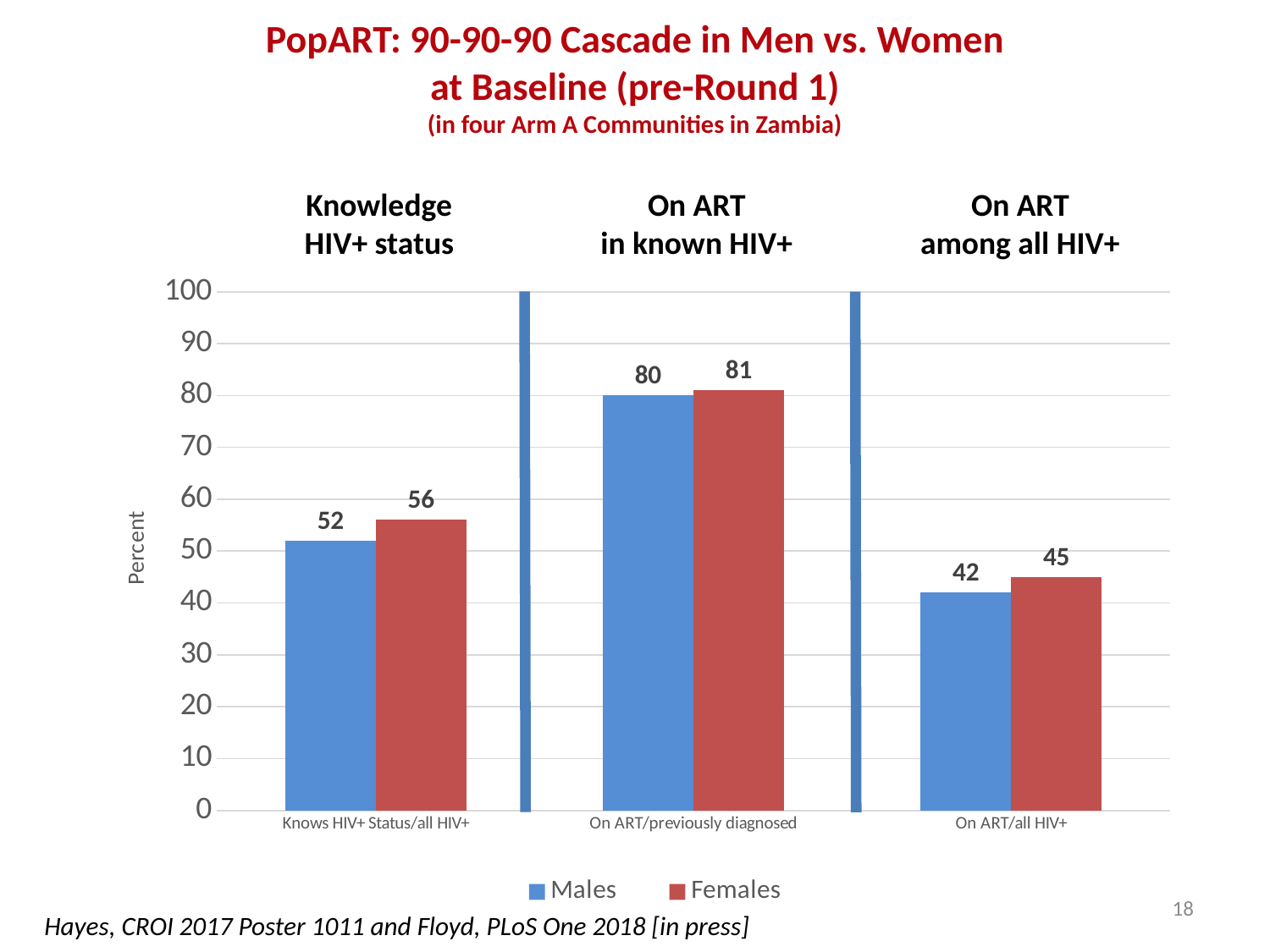
What kind of chart is shown on the slide? Bar chart How many series does the legend list? 2 What is the difference between the Females and Males values in the 'Knows HIV+ Status/all HIV+' category? 4 What is the value for Females in the 'On ART/all HIV+' category? 45 Which category has the lowest value for Females? On ART/all HIV+ How many categories are shown on the x axis? 3 What is the value for Males in the 'Knows HIV+ Status/all HIV+' category? 52 In the 'On ART/all HIV+' category, which series has the larger value, Males or Females? Females Which category has the highest value for Males? On ART/previously diagnosed What is the value for Females in the 'On ART/previously diagnosed' category? 81 What is the label of the y axis? Percent What is the value for Males in the 'On ART/all HIV+' category? 42